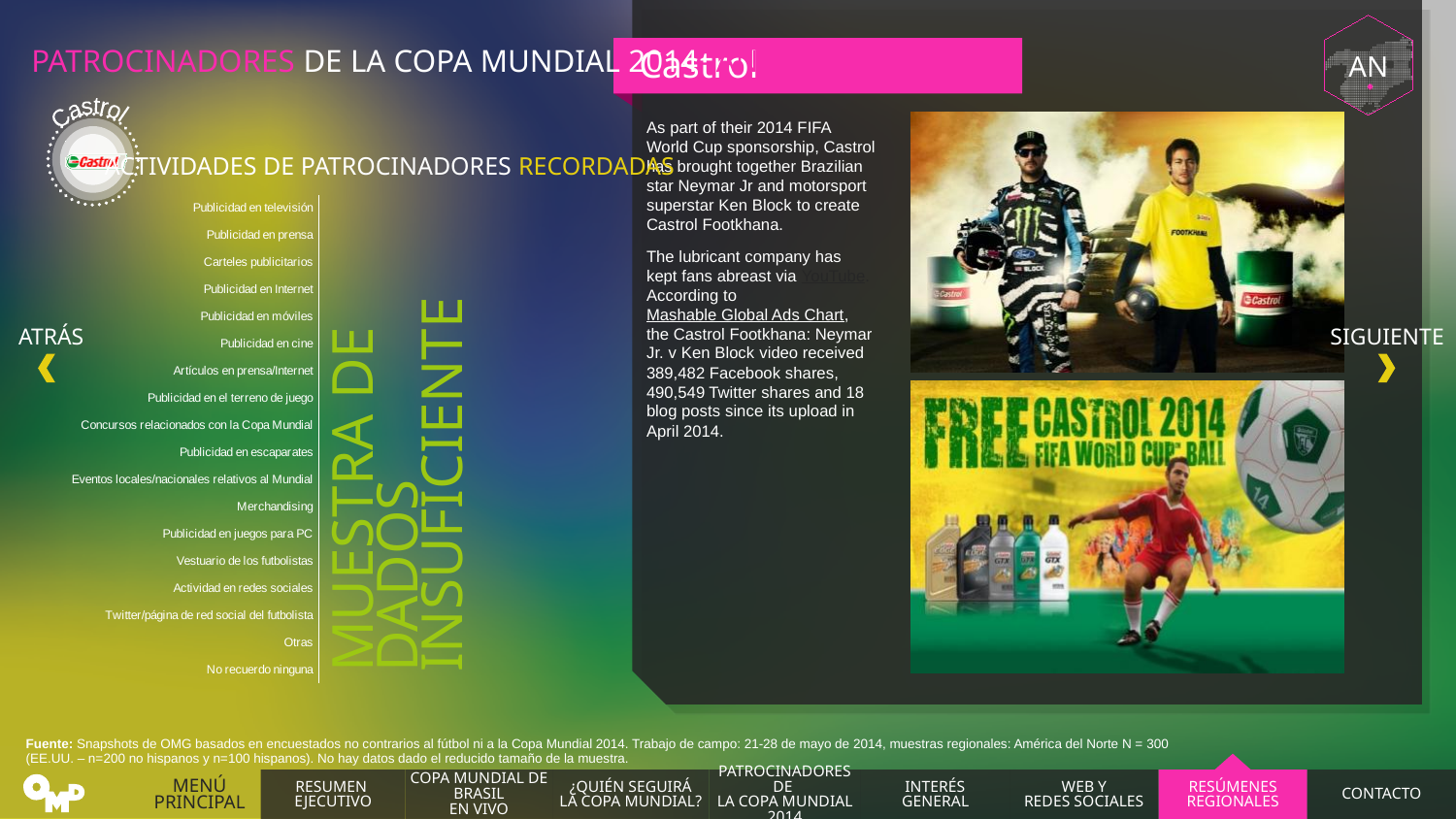
What text is displayed over the chart area in place of plotted data? MUESTRA DE DATOS INSUFICIENTE What is the title of the chart? ACTIVIDADES DE PATROCINADORES RECORDADAS How many categories are listed on the chart's axis? 18 What is the last category listed at the bottom of the chart's axis? No recuerdo ninguna What is the first category listed at the top of the chart's axis? Publicidad en televisión Which category is listed directly below "Merchandising" on the chart's axis? Publicidad en juegos para PC